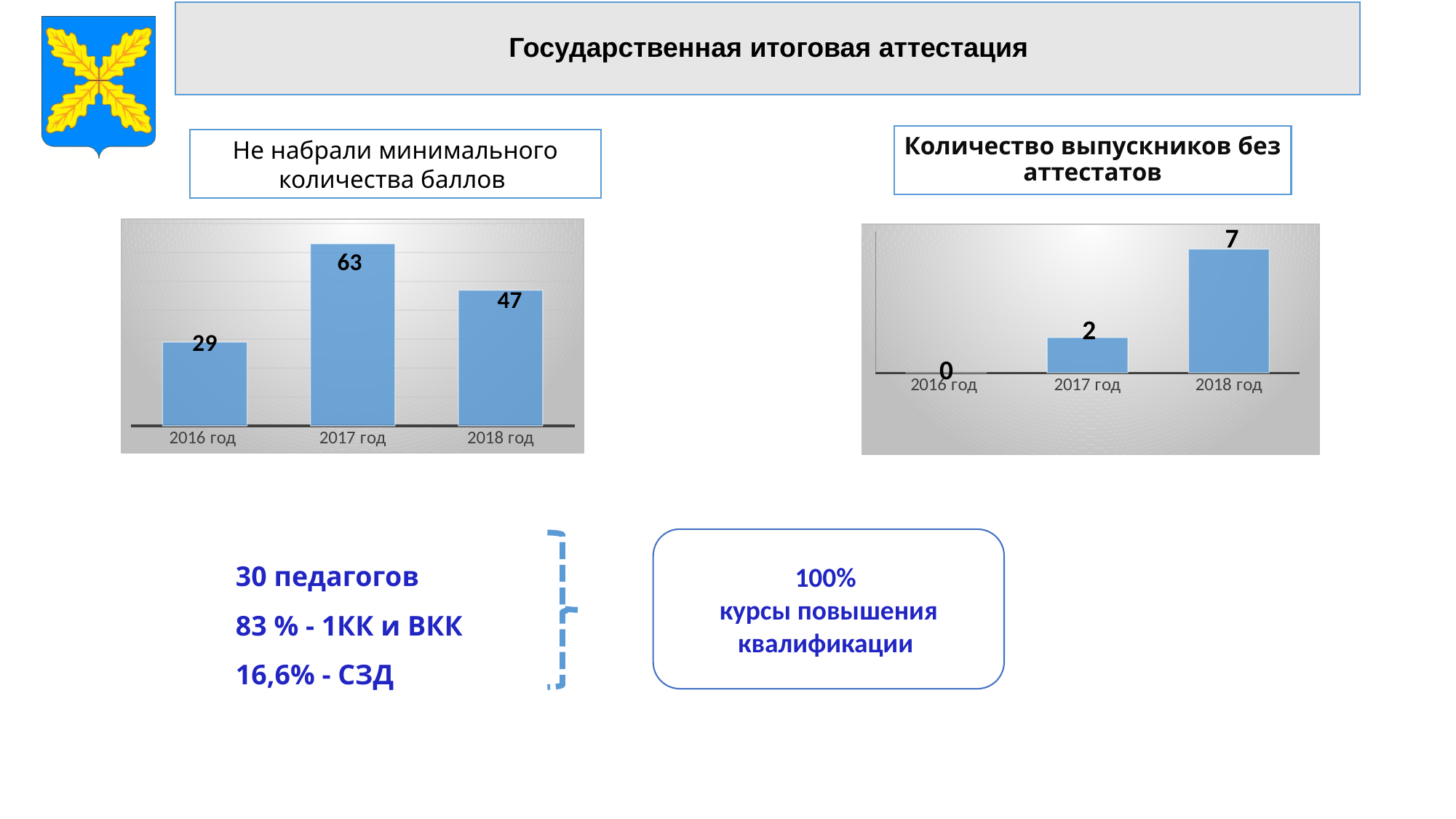
In the left chart ("Не набрали минимального количества баллов"), what is the value for 2017 год? 63 In the right chart ("Количество выпускников без аттестатов"), what is the difference between the values for 2018 год and 2017 год? 5 In the left chart ("Не набрали минимального количества баллов"), what is the value for 2016 год? 29 In the right chart ("Количество выпускников без аттестатов"), which is larger, the value for 2017 год or 2018 год? 2018 год In the right chart ("Количество выпускников без аттестатов"), do the values rise or fall from 2016 год to 2018 год? rise In the left chart ("Не набрали минимального количества баллов"), which year has the lowest value? 2016 год In the right chart ("Количество выпускников без аттестатов"), what is the value for 2016 год? 0 In the left chart ("Не набрали минимального количества баллов"), how many years are shown? 3 What type of chart is the right chart ("Количество выпускников без аттестатов")? bar chart In the left chart ("Не набрали минимального количества баллов"), which year has the highest value? 2017 год In the right chart ("Количество выпускников без аттестатов"), what is the value for 2018 год? 7 In the left chart ("Не набрали минимального количества баллов"), what is the difference between the values for 2017 год and 2018 год? 16